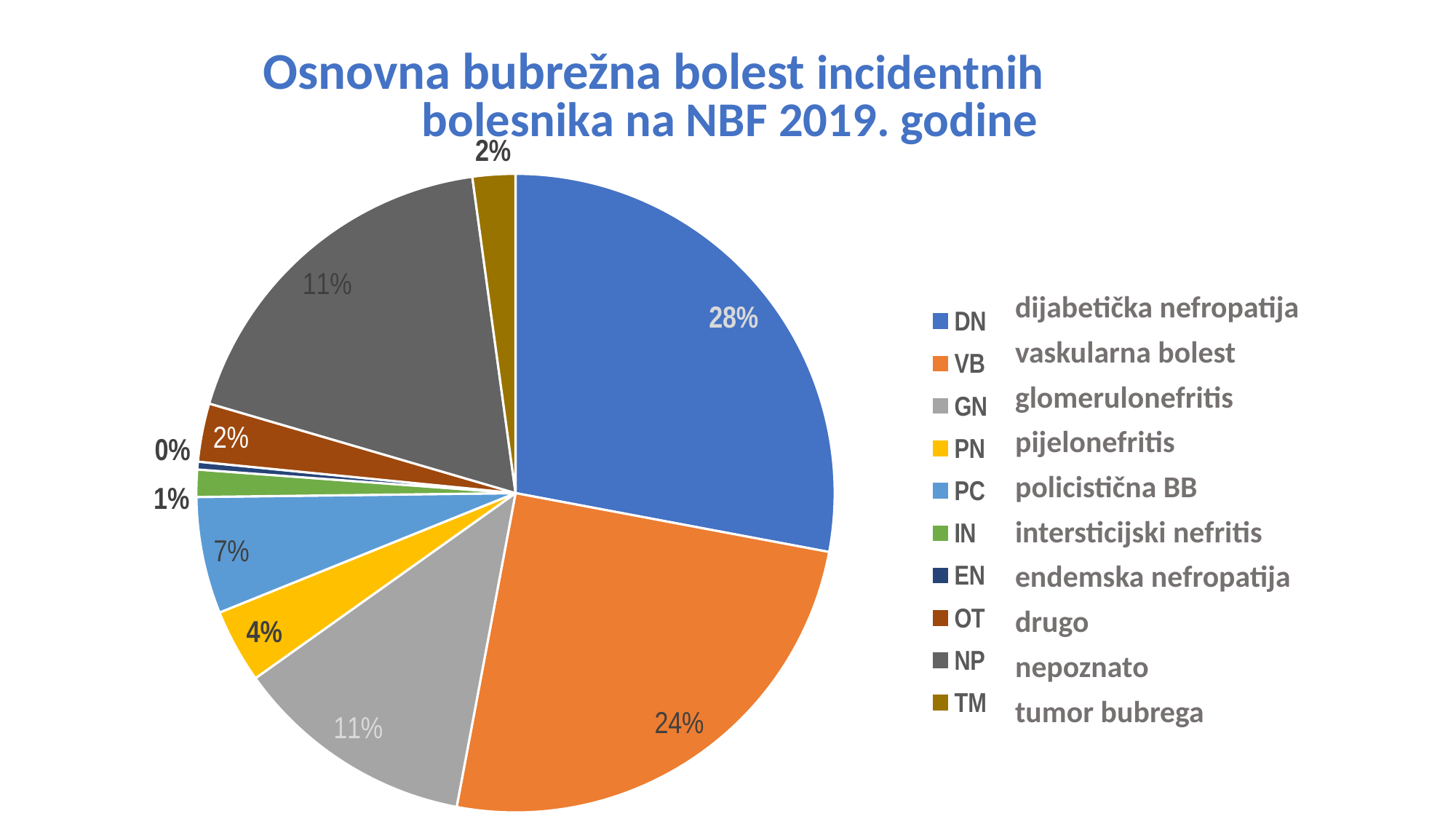
What is the title of the chart? Osnovna bubrežna bolest incidentnih bolesnika na NBF 2019. godine What percentage is shown for PC (policistična BB)? 7% What kind of chart is shown on the slide? pie chart Which is larger, the share for PC or the share for PN? PC How many categories does the legend list? 10 Which category has the largest share of the pie? DN What is the difference in percentage points between DN and VB? 4 Which category has the smallest share of the pie? EN What percentage is shown for PN (pijelonefritis)? 4% What share of the pie does VB (vaskularna bolest) have? 24% What percentage is shown for EN (endemska nefropatija)? 0% What share of the pie does DN (dijabetička nefropatija) have? 28%